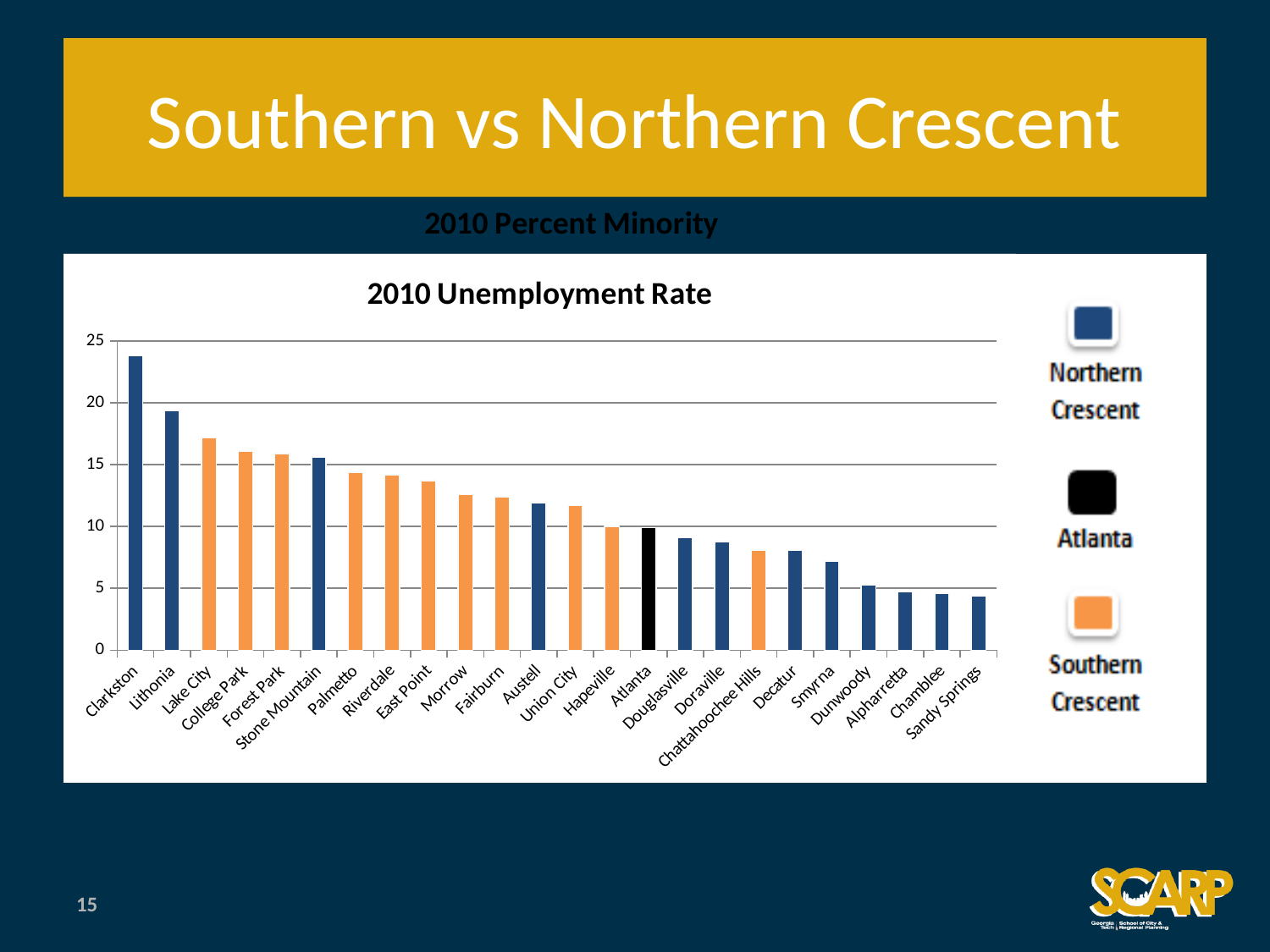
Which has the larger unemployment rate, Lake City or Decatur? Lake City How many entries does the legend list? 3 Is the value for Lake City greater or less than 15? greater How many cities are shown on the x axis of the chart? 24 Is the value for Palmetto greater or less than 15? less Do the values rise or fall moving from left to right along the x axis? fall Is the value for Clarkston greater or less than 20? greater Which city has the highest 2010 unemployment rate? Clarkston What is the title of the chart? 2010 Unemployment Rate What kind of chart is shown on the slide? bar chart